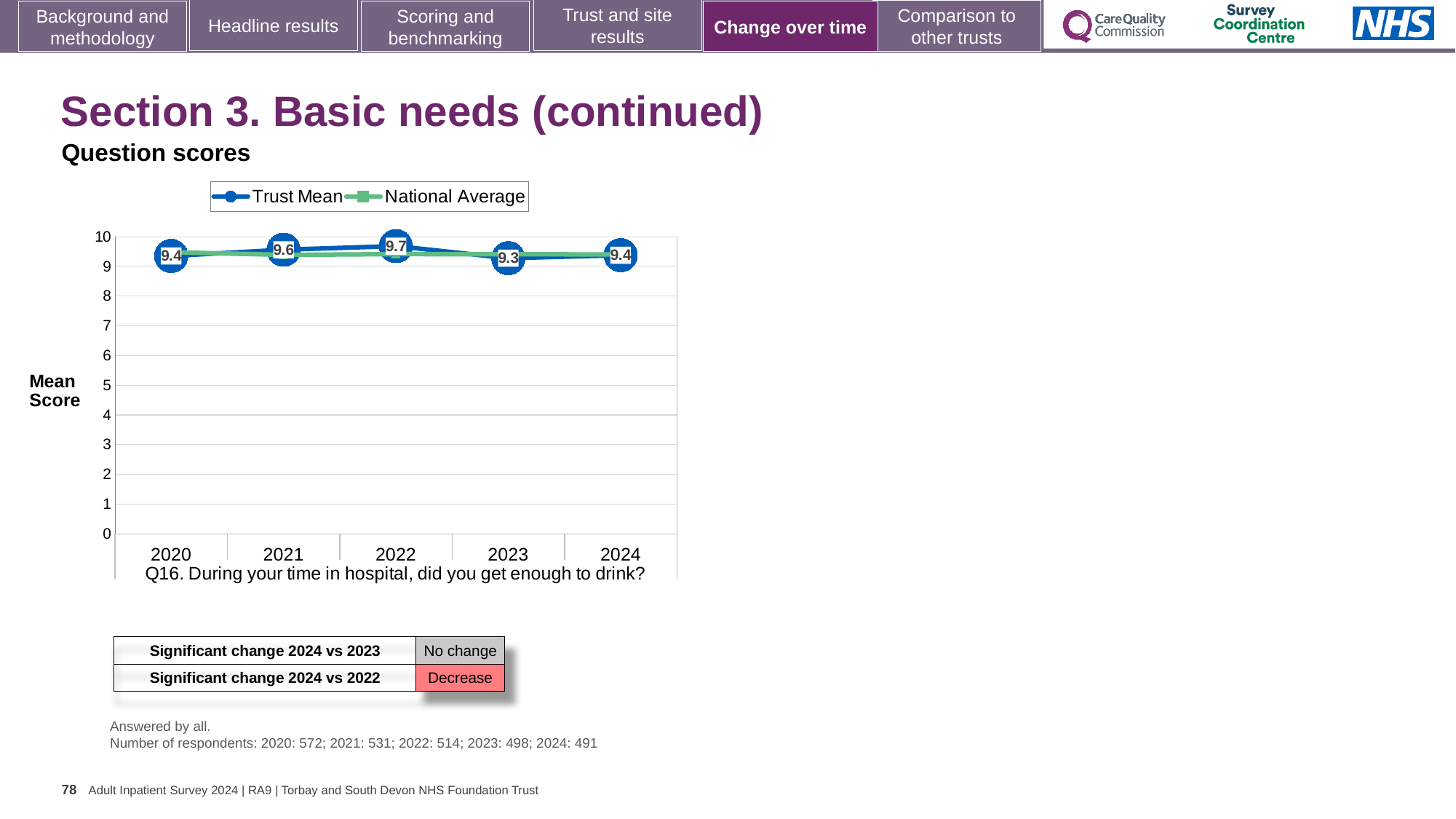
How many series does the legend list? 2 What is the Trust Mean score for 2020? 9.4 What kind of chart is shown on the slide? Line chart What is the Trust Mean score for 2022? 9.7 What is the Trust Mean score for 2023? 9.3 In which year is the Trust Mean score highest? 2022 Does the Trust Mean score rise or fall from 2022 to 2023? Fall How many years are plotted on the x axis? 5 Is the National Average value for 2024 greater or less than 5? greater Which year has the larger Trust Mean score, 2021 or 2023? 2021 In which year is the Trust Mean score lowest? 2023 What is the difference between the Trust Mean scores for 2022 and 2023? 0.4